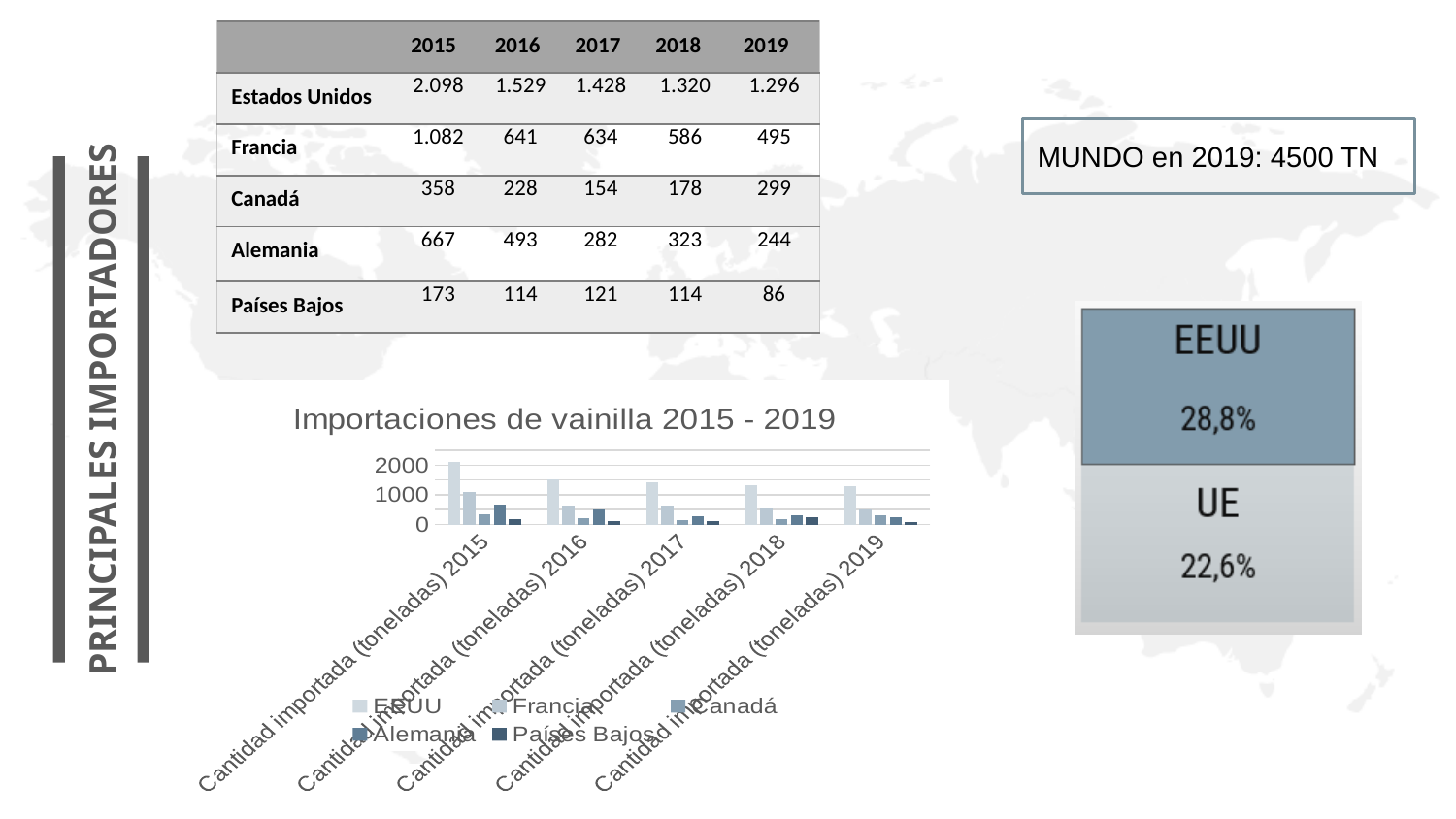
Is the EEUU value for 2016 greater or less than 1000? greater How many series does the chart legend list? 5 Do the EEUU bars rise or fall from 2015 to 2019? fall Is the Alemania value for 2015 greater or less than 1000? less What kind of chart is shown on the slide? bar chart According to the table, how many tonnes did Francia import in 2015? 1.082 Using the table values, what is the difference between Estados Unidos imports in 2015 and 2016? 569 According to the table, how many tonnes did Estados Unidos import in 2019? 1.296 What is the title of the chart? Importaciones de vainilla 2015 - 2019 Which series has the shortest bar in the 2019 group of the chart? Países Bajos Which series has the tallest bar in every year group of the chart? EEUU How many year groups are plotted along the x axis of the chart? 5